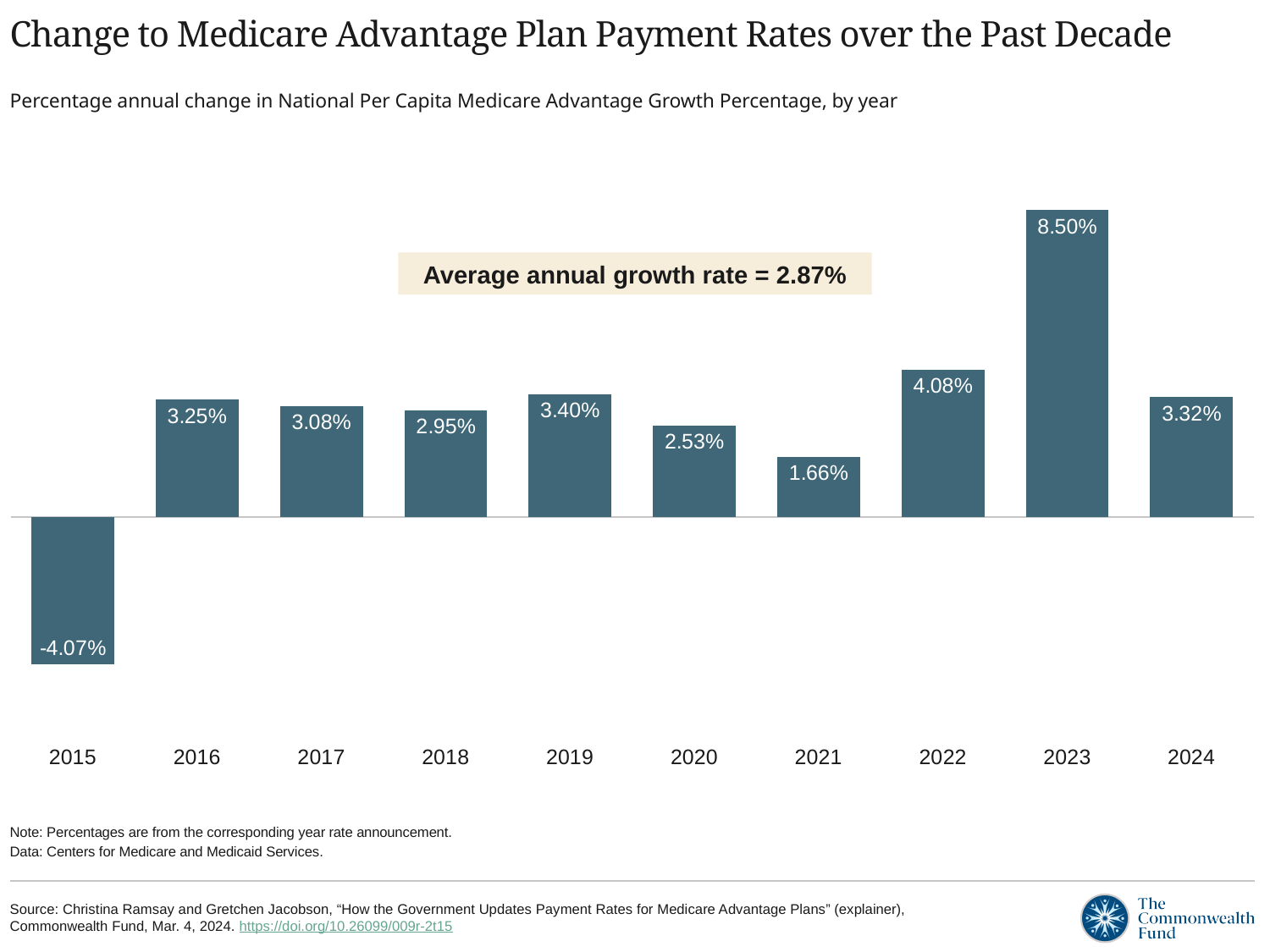
What is the difference between the values for 2023 and 2022? 4.42% How many years are shown on the x axis? 10 What average annual growth rate is stated on the chart? 2.87% What is the difference between the values for 2024 and 2021? 1.66% Which year has the lowest percentage annual change? 2015 Which year has the larger value, 2016 or 2018? 2016 What is the percentage annual change shown for 2015? -4.07% What is the percentage annual change shown for 2021? 1.66% What is the percentage annual change shown for 2023? 8.50% Which year has the larger value, 2019 or 2020? 2019 What kind of chart is shown on the slide? Bar chart Which year has the highest percentage annual change? 2023